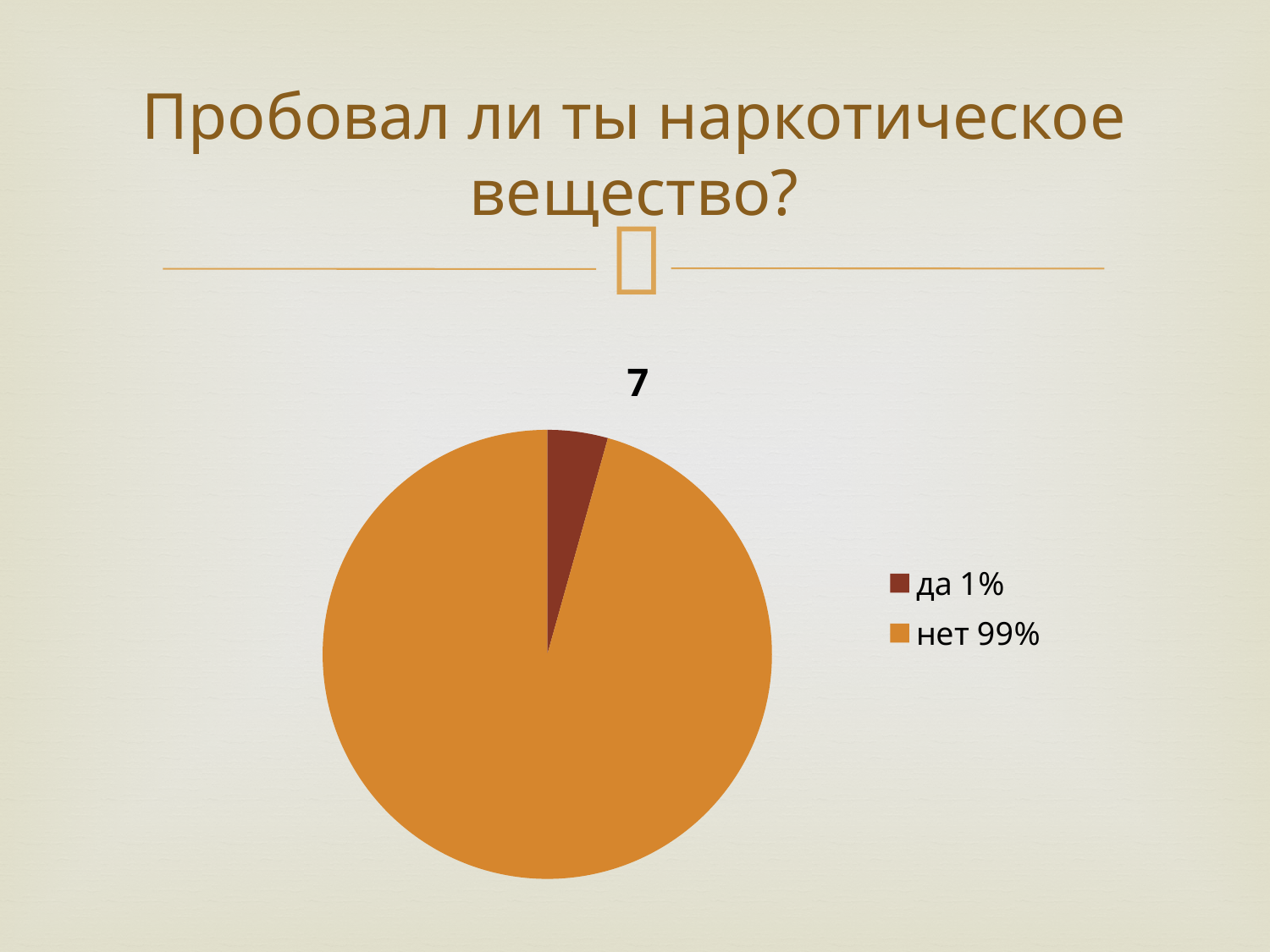
What is the difference in percentage points between the "нет" share and the "да" share shown in the legend? 98 What share of the pie does the legend give for "да"? 1% What share of the pie does the legend give for "нет"? 99% What is the title shown above the pie chart? 7 Which slice of the pie chart is the largest? нет What is the question written as the slide title above the pie chart? Пробовал ли ты наркотическое вещество? How many slices does the pie chart have? 2 How many entries does the legend of the pie chart list? 2 Which is larger in the pie chart, the slice for "да" or the slice for "нет"? нет Which slice of the pie chart is the smallest? да What kind of chart is shown on the slide? pie chart